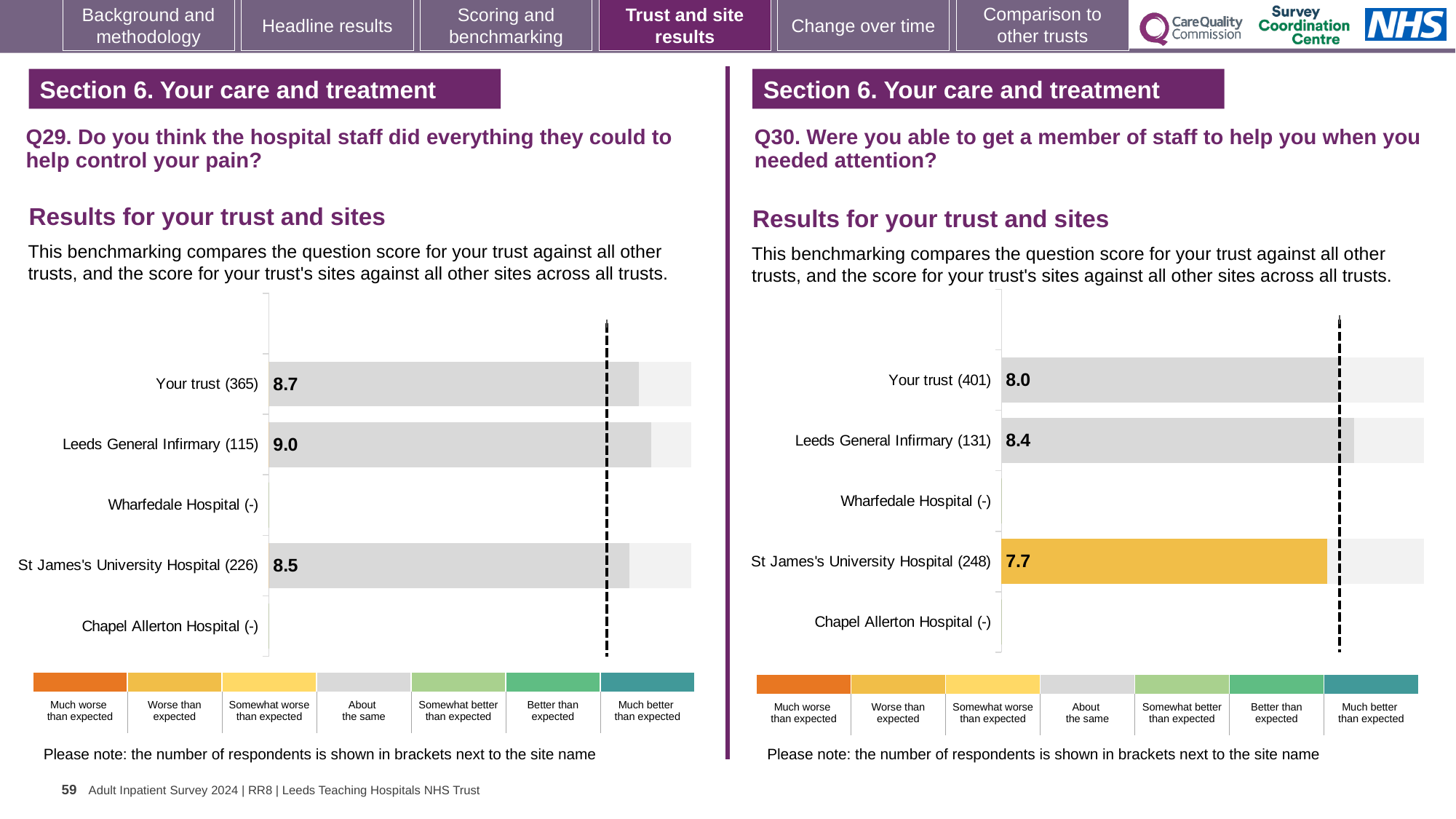
On the Q29 chart (left), which site has the highest score? Leeds General Infirmary On the Q29 chart (left), what is the difference between the scores for Leeds General Infirmary and St James's University Hospital? 0.5 On the Q29 chart (left), what is the score for Your trust? 8.7 On the Q29 chart (left), what is the score for St James's University Hospital? 8.5 On the Q30 chart (right), what is the score for St James's University Hospital? 7.7 On the Q29 chart (left), what is the score for Leeds General Infirmary? 9.0 What kind of chart is used on the Q29 chart (left)? bar chart On the Q30 chart (right), what is the difference between the scores for Leeds General Infirmary and St James's University Hospital? 0.7 On the Q30 chart (right), is the score for Leeds General Infirmary larger or smaller than the score for Your trust? larger On the Q30 chart (right), what is the score for Your trust? 8.0 On the Q30 chart (right), which site has the lowest score among those with a score shown? St James's University Hospital On the Q30 chart (right), how many respondents are shown for Your trust? 401